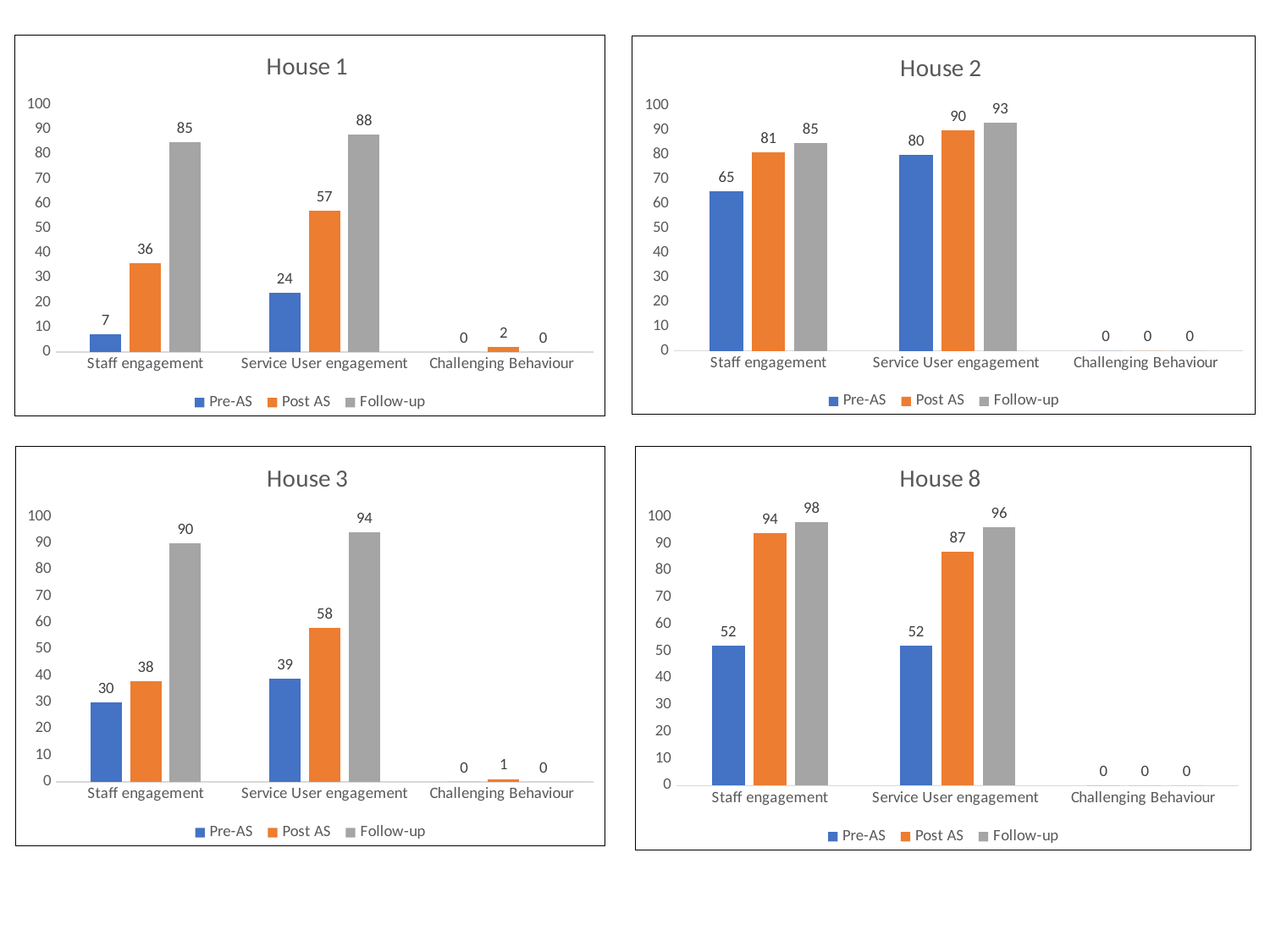
How many series does the legend list in the House 8 chart? 3 What kind of chart is the House 2 chart? Bar chart In the House 2 chart, what is the Pre-AS value for Service User engagement? 80 How many categories are shown on the x axis of the House 1 chart? 3 In the House 8 chart, what is the Follow-up value for Staff engagement? 98 In the House 3 chart, which series has the highest value for Service User engagement? Follow-up What colour represents the Post AS series in the House 3 chart? Orange In the House 1 chart, what is the Follow-up value for Staff engagement? 85 In the House 1 chart, what is the difference between the Follow-up and Pre-AS values for Service User engagement? 64 In the House 8 chart, do the Staff engagement values rise or fall from Pre-AS to Follow-up? Rise In the House 2 chart, is the Post AS value for Staff engagement larger than the Pre-AS value for Service User engagement? Yes, 81 is larger than 80 In the House 3 chart, what is the Post AS value for Challenging Behaviour? 1